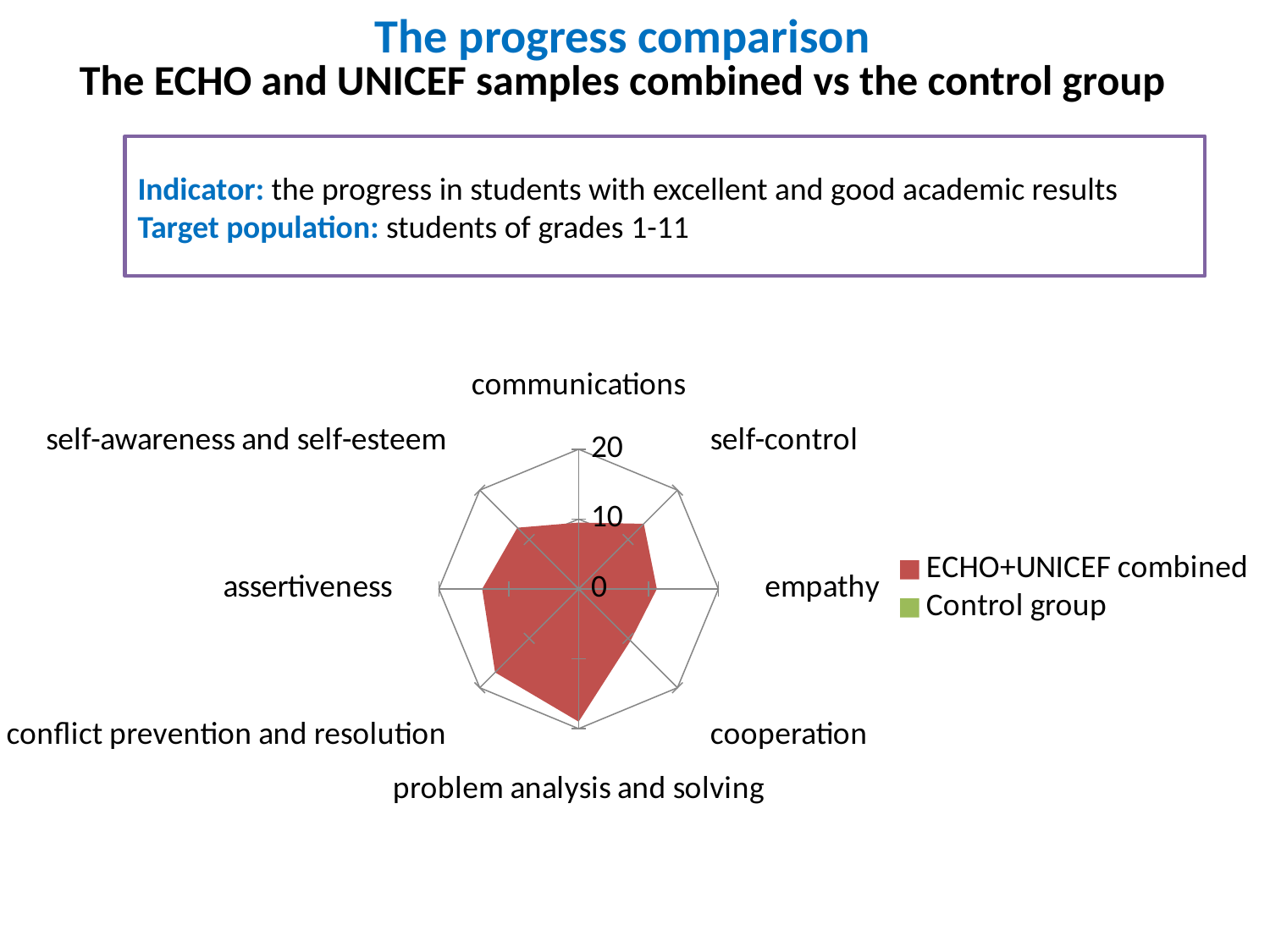
What colour represents the ECHO+UNICEF combined series? red Is the ECHO+UNICEF combined value for empathy greater or less than 20? less Is the ECHO+UNICEF combined value for conflict prevention and resolution greater or less than 10? greater How many series does the legend list? 2 What kind of chart is shown on the slide? radar chart For ECHO+UNICEF combined, which is larger: problem analysis and solving or empathy? problem analysis and solving Is the ECHO+UNICEF combined value for problem analysis and solving greater or less than 10? greater For ECHO+UNICEF combined, which is larger: conflict prevention and resolution or self-control? conflict prevention and resolution Which category has the highest value for ECHO+UNICEF combined? problem analysis and solving How many categories (axes) does the radar chart have? 8 What are the two series named in the legend? ECHO+UNICEF combined and Control group